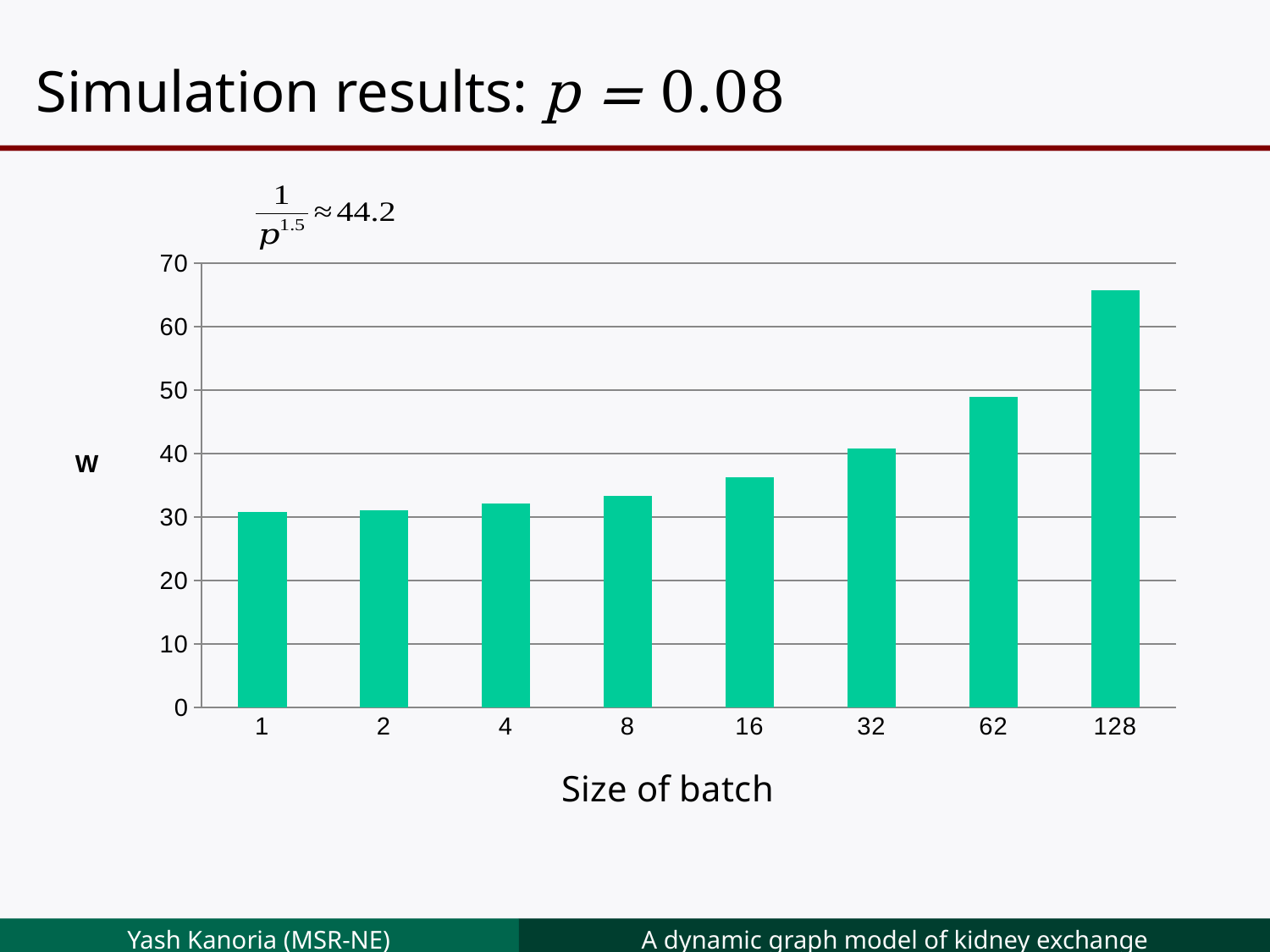
Is the value of w for batch size 128 greater or less than 60? greater Which has a larger value of w: batch size 62 or batch size 128? 128 Which has a larger value of w: batch size 8 or batch size 32? 32 Is the value of w for batch size 62 greater or less than 50? less What is the title of the x axis of the chart? Size of batch What kind of chart is shown on the slide? bar chart How many batch sizes are plotted on the x axis? 8 Is the value of w for batch size 1 greater or less than 40? less Which size of batch has the highest value of w? 128 Do the values of w rise or fall as the size of batch increases along the x axis? rise